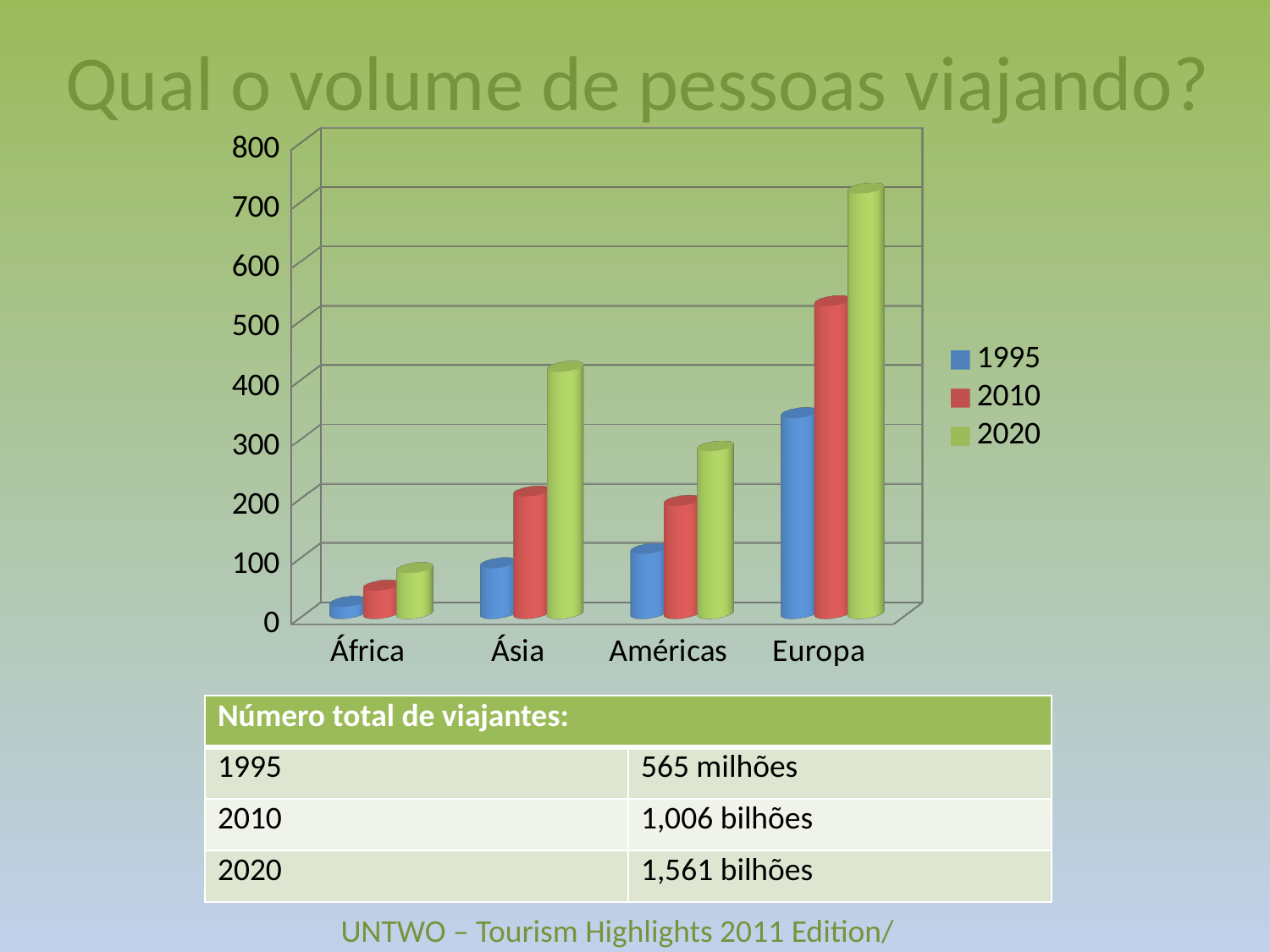
How many regions are shown on the x axis of the chart? 4 Which is larger, the 2020 value for Europa or the 2020 value for Ásia? Europa Is the value for Europa in 1995 greater or less than 300? greater What kind of chart is shown on the slide? bar chart Which region has the lowest value for the 1995 series? África Which region has the highest value for the 2020 series? Europa For Ásia, do the values rise or fall from 1995 to 2020? rise Which legend entry is shown in red? 2010 Is the value for Europa in 2010 greater or less than 500? greater Is the value for Américas in 2020 greater or less than 300? less How many series does the chart legend list? 3